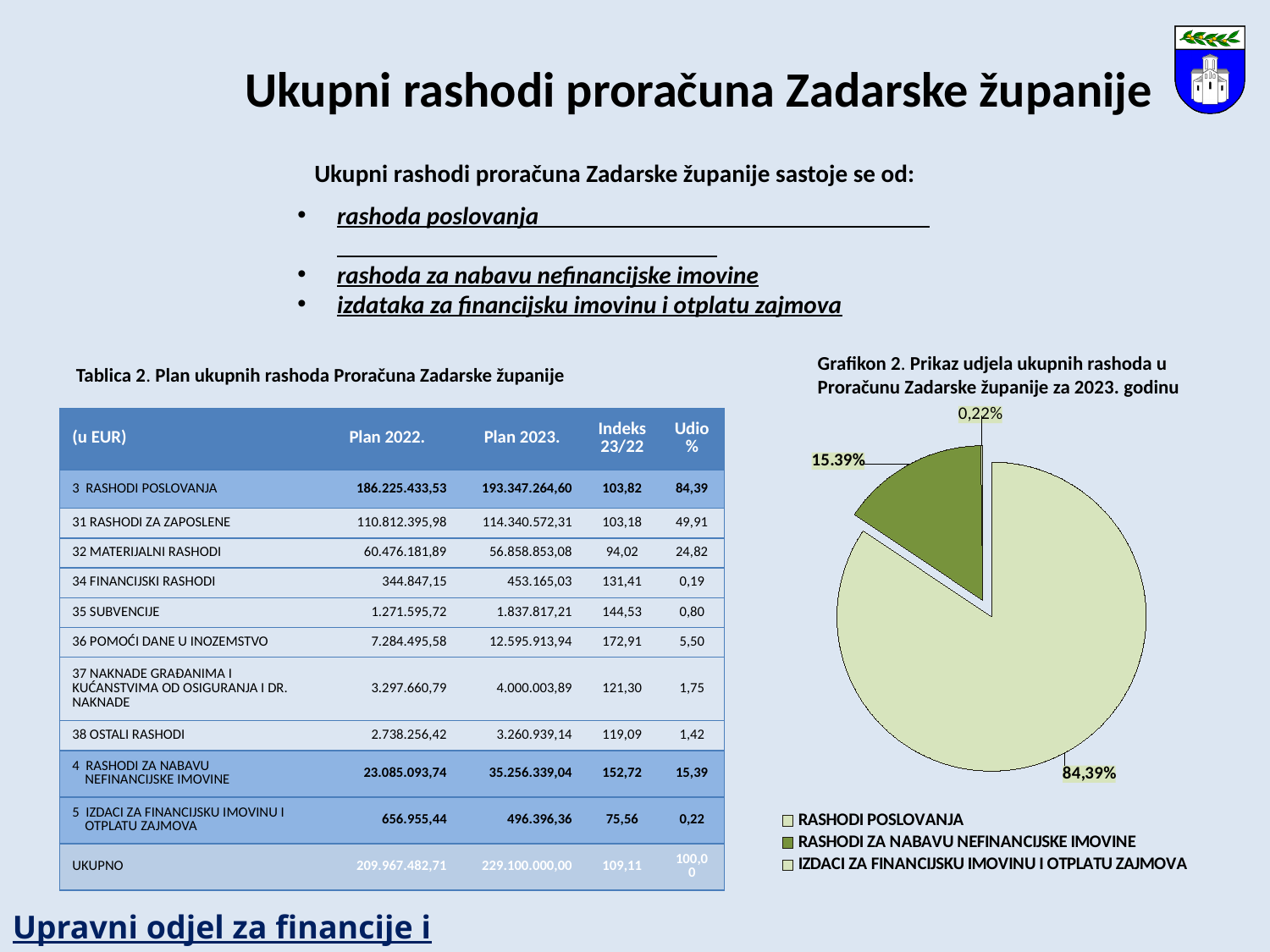
How many slices does the pie chart have? 3 In the pie chart, which category is shown in the dark green colour? RASHODI ZA NABAVU NEFINANCIJSKE IMOVINE In the pie chart, what share is shown for RASHODI ZA NABAVU NEFINANCIJSKE IMOVINE? 15.39% Which category has the smallest slice in the pie chart? IZDACI ZA FINANCIJSKU IMOVINU I OTPLATU ZAJMOVA In the pie chart, what share is shown for IZDACI ZA FINANCIJSKU IMOVINU I OTPLATU ZAJMOVA? 0,22% In the pie chart, which is larger: the slice for RASHODI ZA NABAVU NEFINANCIJSKE IMOVINE or the slice for IZDACI ZA FINANCIJSKU IMOVINU I OTPLATU ZAJMOVA? RASHODI ZA NABAVU NEFINANCIJSKE IMOVINE How many entries does the legend of the pie chart list? 3 What is the title of the pie chart on the slide? Grafikon 2. Prikaz udjela ukupnih rashoda u Proračunu Zadarske županije za 2023. godinu In the pie chart, what share is shown for RASHODI POSLOVANJA? 84,39% What kind of chart is Grafikon 2 on the slide? pie chart Which category has the largest slice in the pie chart? RASHODI POSLOVANJA